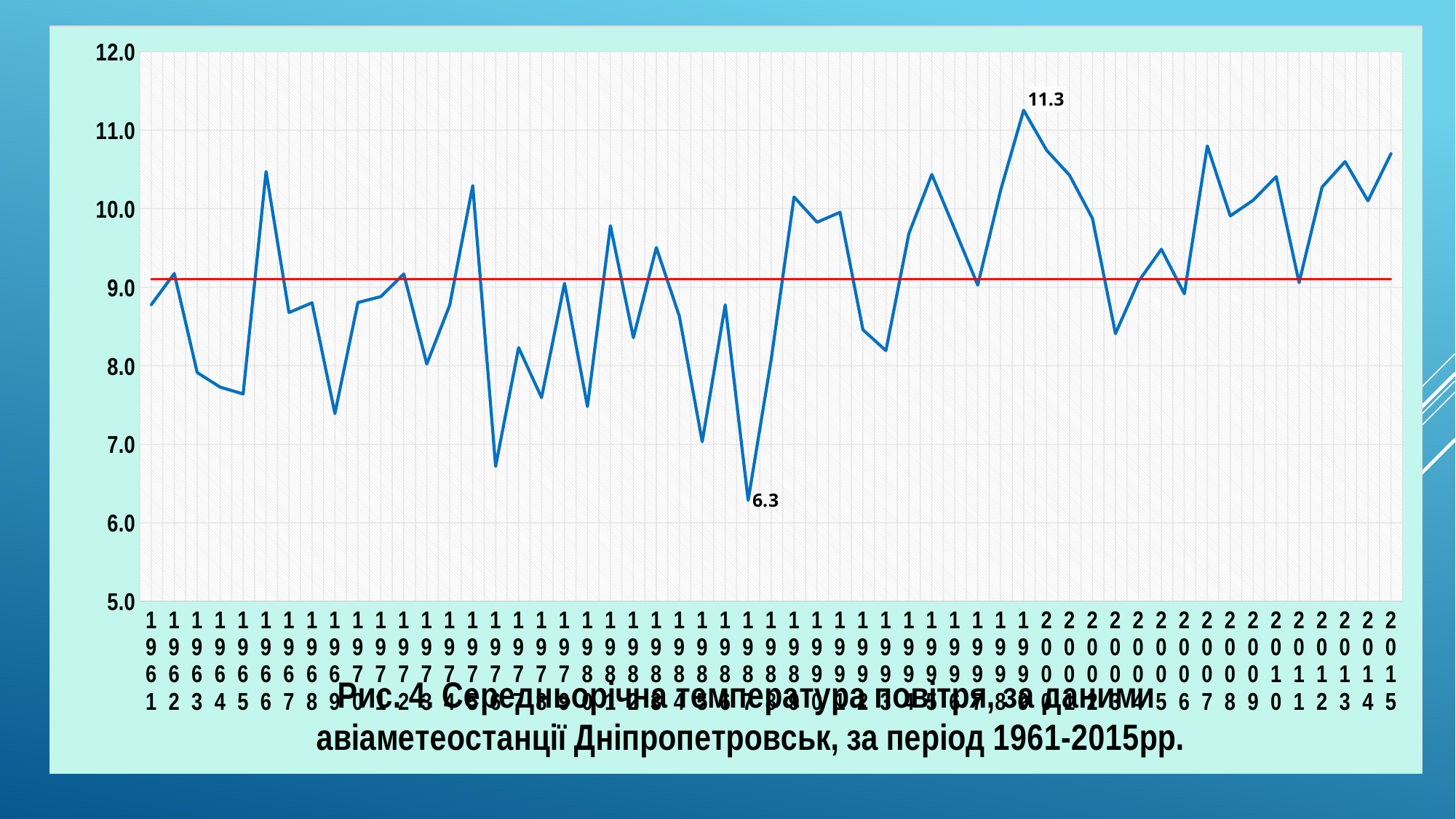
How many years (data points) does the chart cover, from 1961 to 2015? 55 Is the value for 1963 greater or less than 9.0? less From 1962 to 1965, do the values rise or fall? fall What is the lowest value labelled on the chart? 6.3 Which year has the higher value, 1963 or 1966? 1966 What is the highest value labelled on the chart? 11.3 What period does the chart caption say the data covers? 1961-2015 What is the difference between the highest labelled value (11.3) and the lowest labelled value (6.3)? 5.0 Is the value for 1966 greater or less than 10.0? greater Is the value for 2015 greater or less than 10.0? greater What is the range of the vertical axis, from its lowest to highest tick? 5.0 to 12.0 What kind of chart is shown on the slide? line chart